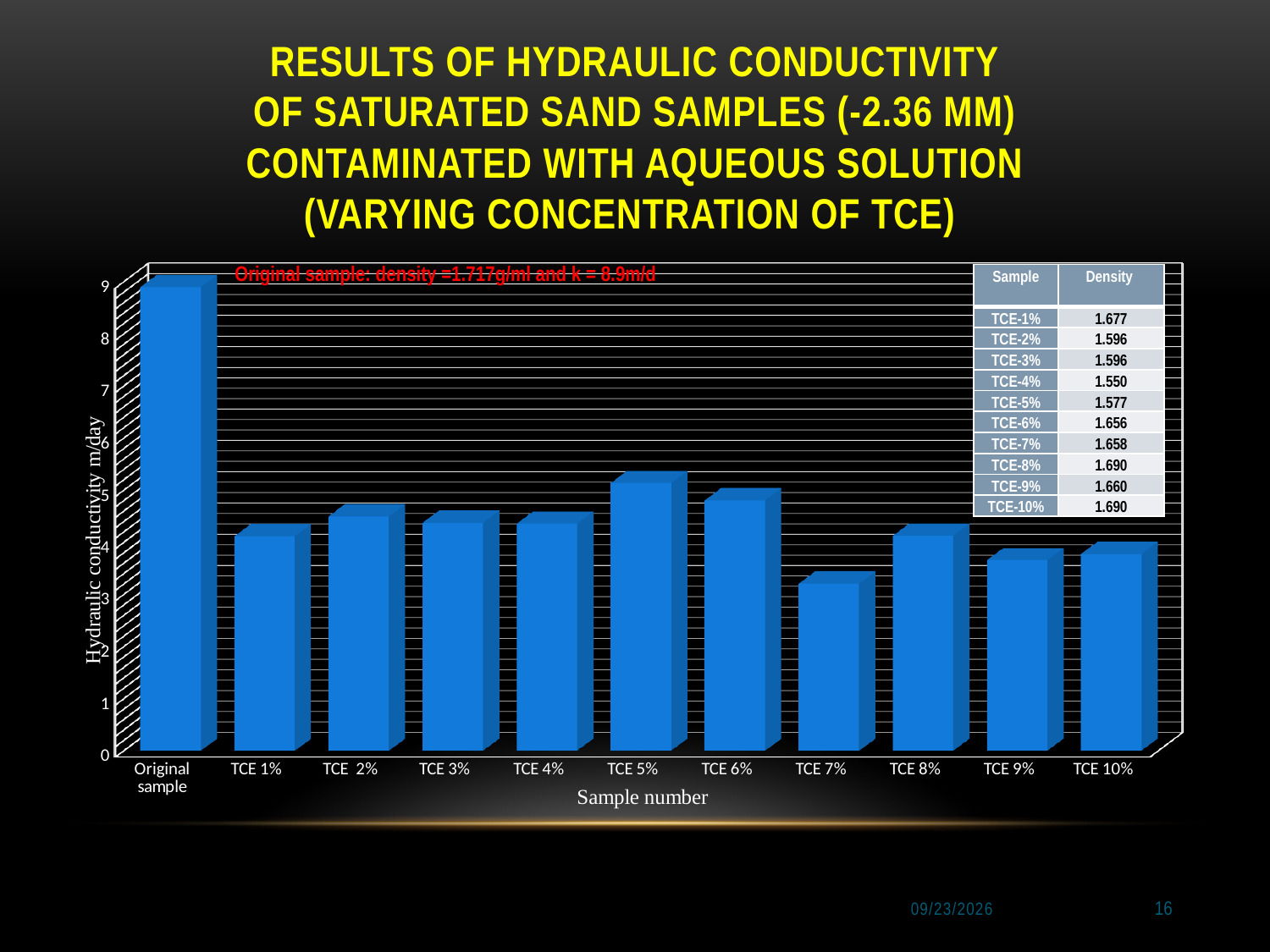
Which sample has the highest hydraulic conductivity? Original sample Which sample has the lowest hydraulic conductivity? TCE 7% What is the label of the vertical axis of the chart? Hydraulic conductivity m/day Is the hydraulic conductivity for TCE 7% greater or less than 4? less What is the label of the horizontal axis of the chart? Sample number Among the TCE-contaminated samples, which has the highest hydraulic conductivity? TCE 5% Is the hydraulic conductivity for TCE 5% greater or less than 5? greater Is the hydraulic conductivity for TCE 6% greater or less than 5? less What kind of chart is shown on the slide? bar chart How many samples (bars) are plotted on the chart? 11 Which has the larger hydraulic conductivity, TCE 5% or TCE 7%? TCE 5%